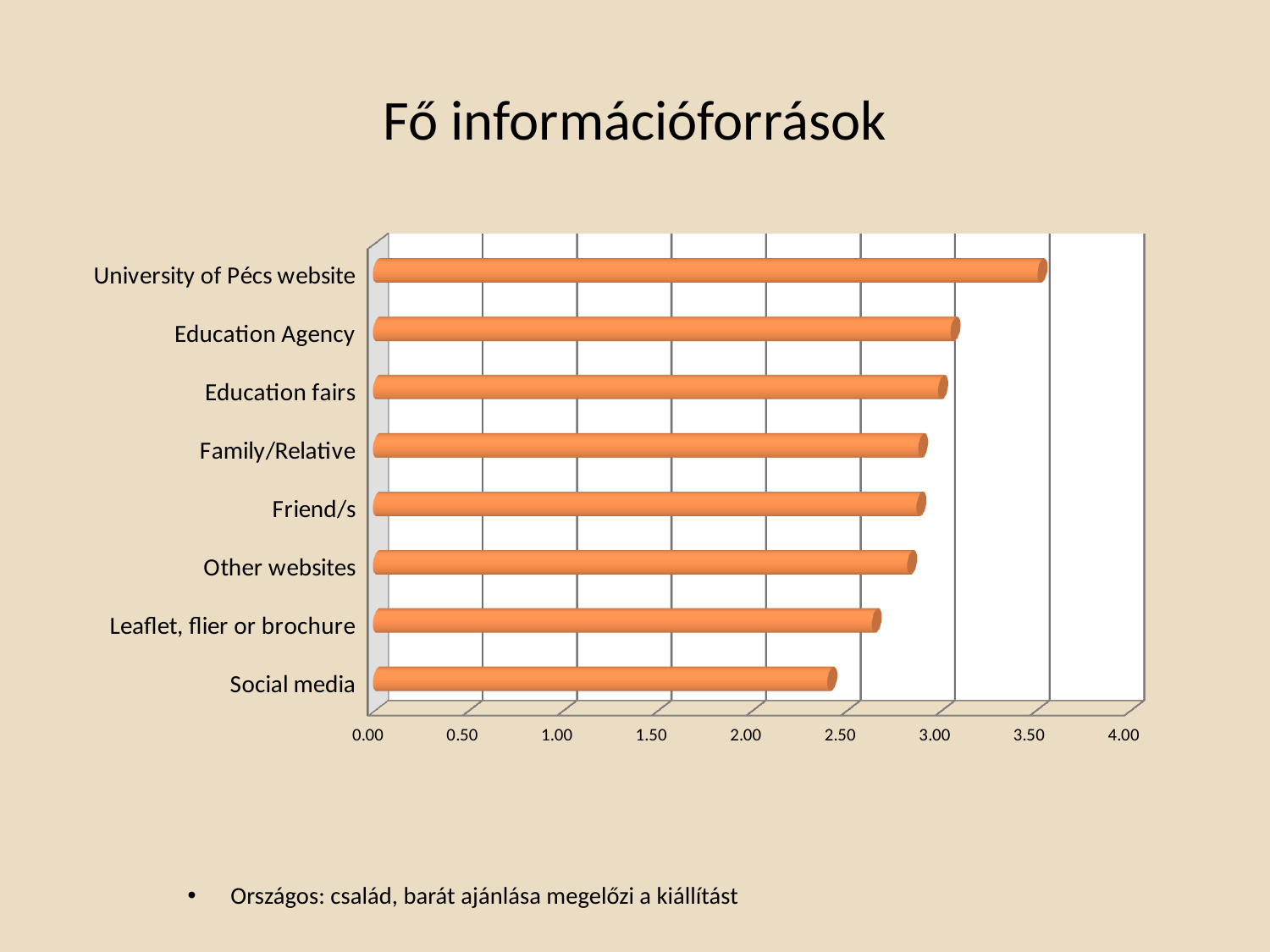
Which has a larger value, University of Pécs website or Education Agency? University of Pécs website What kind of chart is shown on the slide? bar chart Is the value for Family/Relative greater or less than 2.50? greater Which has a larger value, Social media or Leaflet, flier or brochure? Leaflet, flier or brochure Is the value for Social media greater or less than 3.00? less Which category has the highest value? University of Pécs website How many categories are plotted in the chart? 8 What is the maximum value shown on the horizontal axis? 4.00 Is the value for Leaflet, flier or brochure greater or less than 3.00? less What is the title of the chart? Fő információforrások Which category has the lowest value? Social media